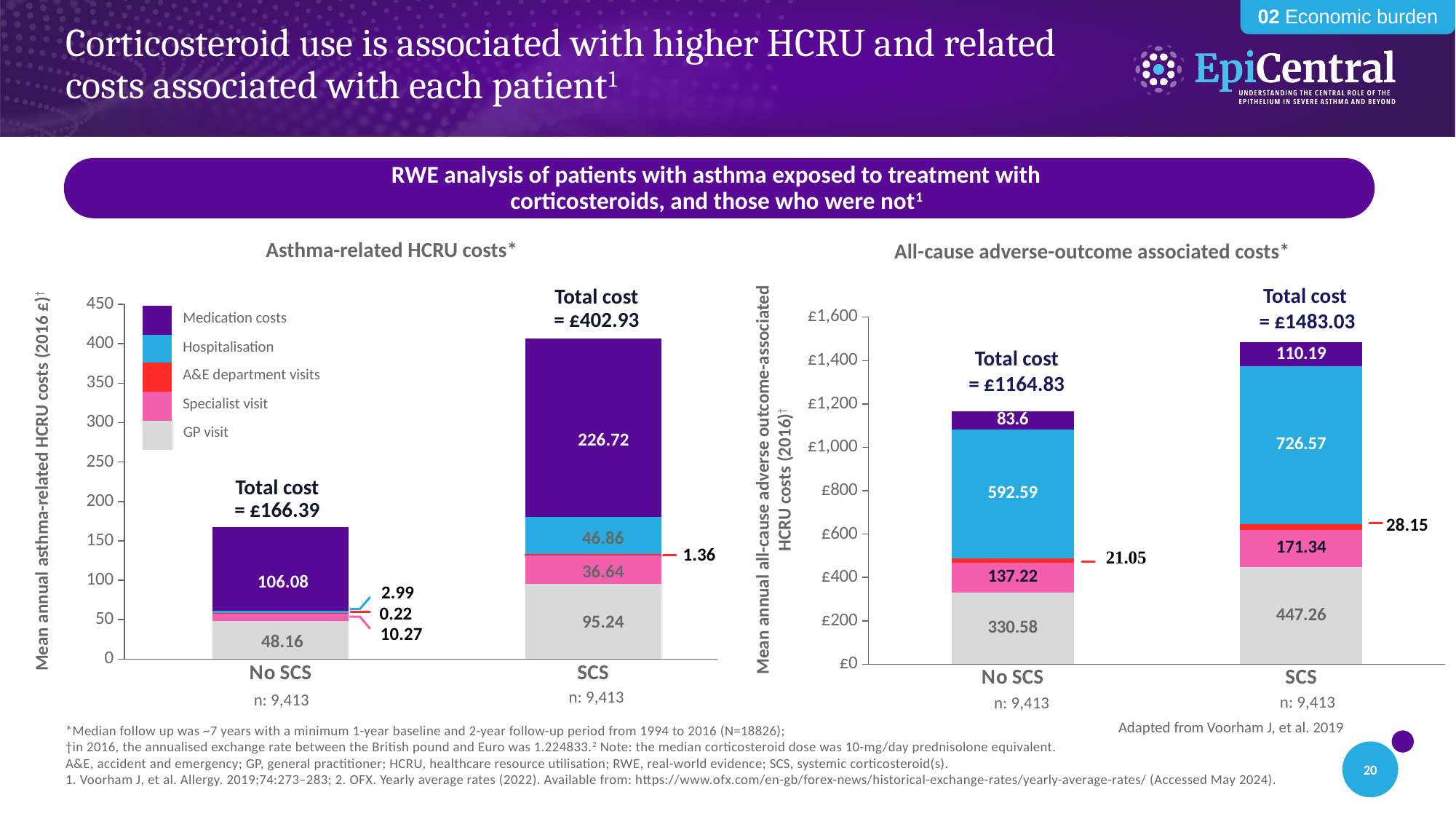
What type of chart is the 'All-cause adverse-outcome associated costs' chart? Stacked bar chart In the 'Asthma-related HCRU costs' chart, what is the total cost for the SCS group? £402.93 In the 'Asthma-related HCRU costs' chart, what is the difference between the medication costs of the SCS and No SCS groups? 120.64 In the 'All-cause adverse-outcome associated costs' chart, which group has the higher GP visit cost, No SCS or SCS? SCS In the 'All-cause adverse-outcome associated costs' chart, what is the total cost for the No SCS group? £1164.83 In the 'All-cause adverse-outcome associated costs' chart, what is the A&E department visits cost for the No SCS group? 21.05 In the 'All-cause adverse-outcome associated costs' chart, which cost component is the largest for the SCS group? Hospitalisation How many series does the legend list in the 'Asthma-related HCRU costs' chart? 5 In the 'Asthma-related HCRU costs' chart, what is the medication cost for the SCS group? 226.72 In the 'Asthma-related HCRU costs' chart, what is the GP visit cost for the No SCS group? 48.16 In the 'All-cause adverse-outcome associated costs' chart, what is the hospitalisation cost for the SCS group? 726.57 In the 'Asthma-related HCRU costs' chart, what colour represents hospitalisation? Blue